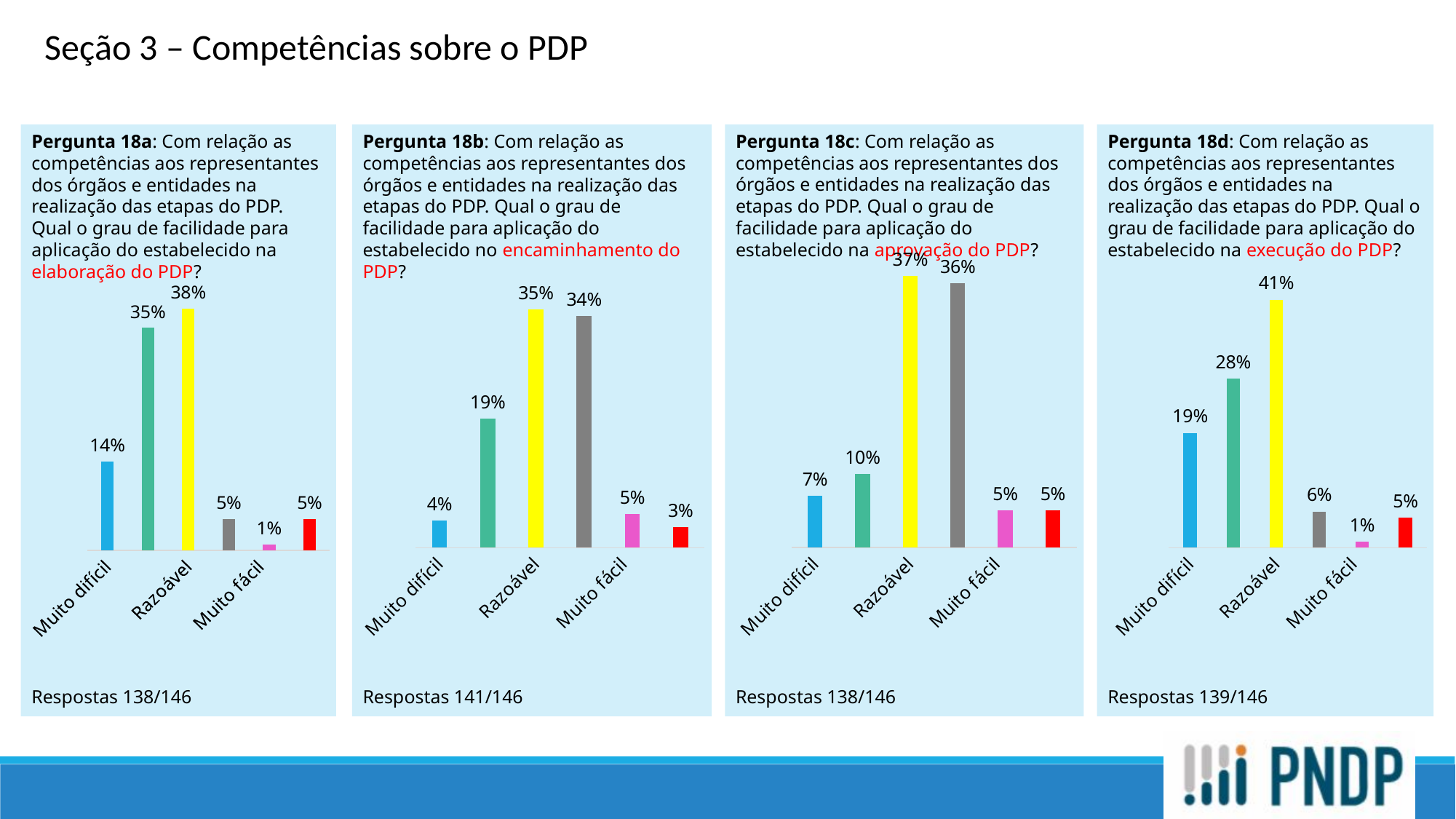
In the Pergunta 18a chart, what is the value for Razoável? 38% In the Pergunta 18b chart, which is larger, the value for Muito difícil or the value for Muito fácil? Muito fácil In the Pergunta 18a chart, what is the value for Muito difícil? 14% In the Pergunta 18d chart, what is the difference between the values for Razoável and Muito difícil? 22% How many bars are plotted in the Pergunta 18c chart? 6 What kind of chart is used for Pergunta 18a? Bar chart In the Pergunta 18d chart, what is the value for Razoável? 41% How many responses are reported for the Pergunta 18b chart? 141/146 In the Pergunta 18a chart, which labelled category has the lowest value? Muito fácil In the Pergunta 18c chart, what is the value for Muito difícil? 7% In the Pergunta 18d chart, which labelled category has the highest value? Razoável In the Pergunta 18b chart, what is the value for Muito fácil? 5%